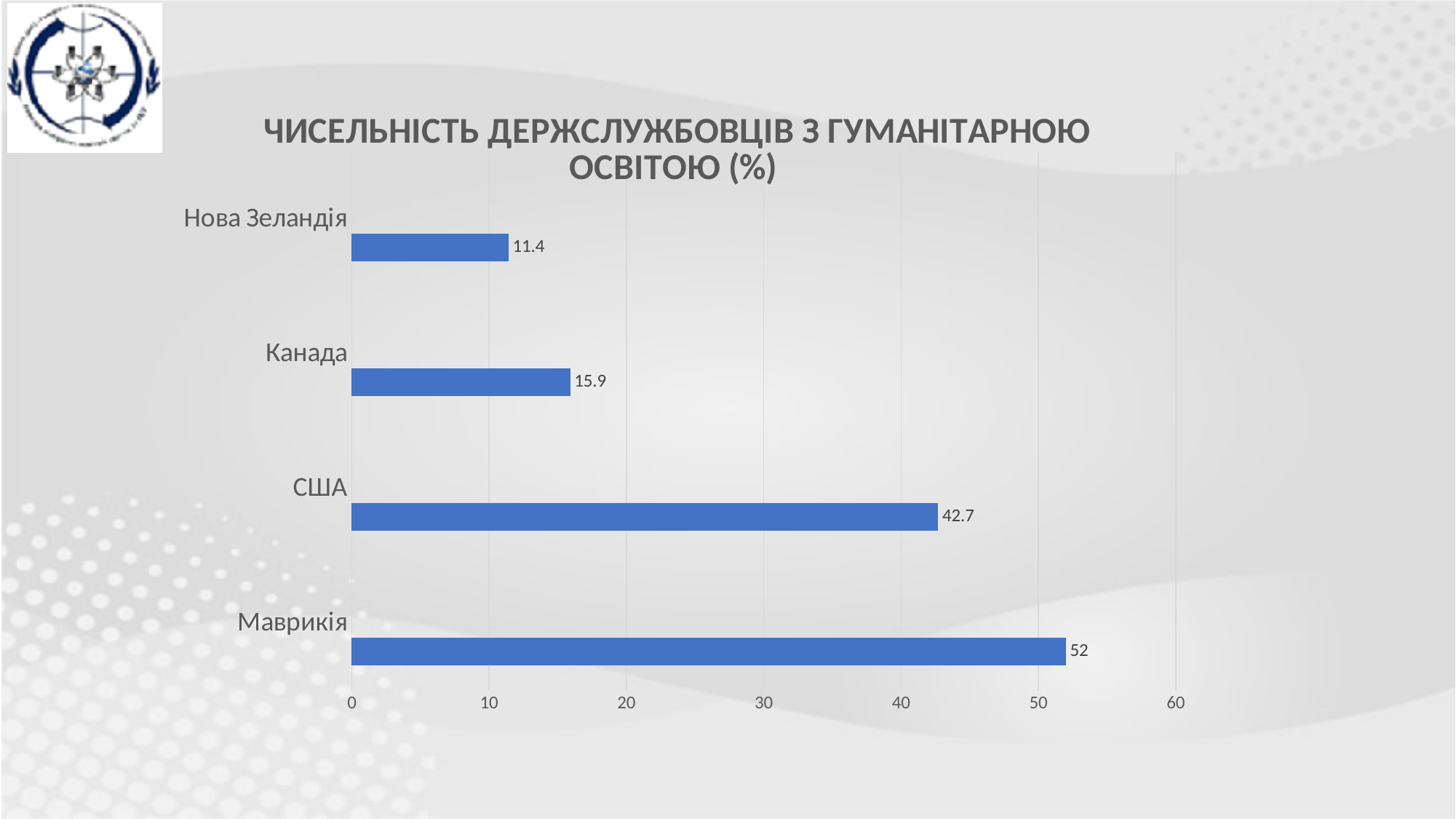
What kind of chart is shown on the slide? Bar chart What is the value for Канада? 15.9 What is the value for Нова Зеландія? 11.4 What is the value for США? 42.7 Which country has the highest value? Маврикія How many countries are shown in the chart? 4 What is the difference between the values for Канада and Нова Зеландія? 4.5 Which has a larger value, Канада or США? США Which country has the lowest value? Нова Зеландія What is the difference between the values for Маврикія and США? 9.3 Is the value for США greater or less than 40? greater What is the value for Маврикія? 52